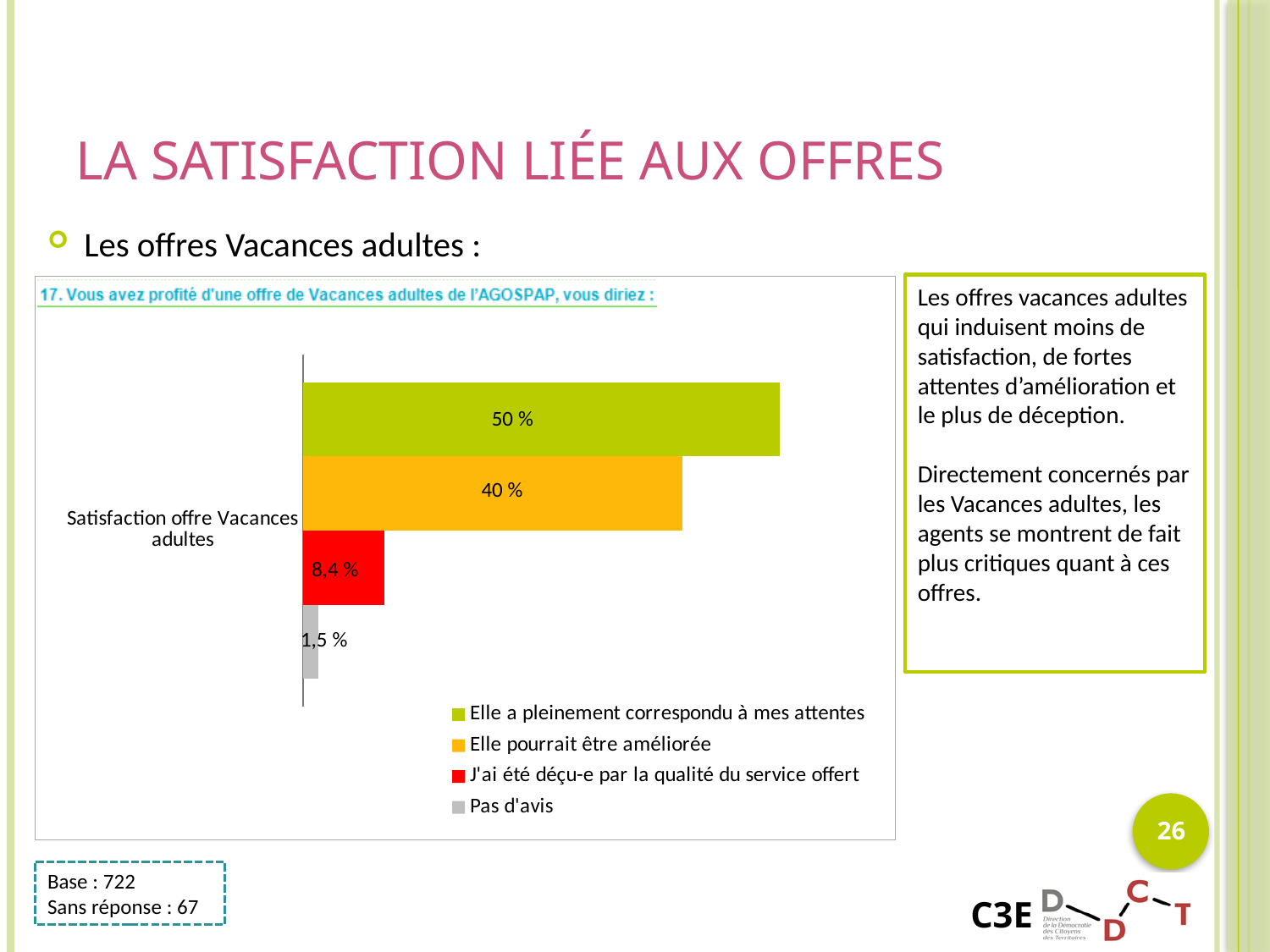
Which legend entry has the highest value? Elle a pleinement correspondu à mes attentes What value is shown for "Pas d'avis"? 1,5 % What is the difference between the values for "Elle a pleinement correspondu à mes attentes" and "Elle pourrait être améliorée"? 10 % How many series does the legend list? 4 Which is larger: the value for "J'ai été déçu-e par la qualité du service offert" or the value for "Pas d'avis"? J'ai été déçu-e par la qualité du service offert What kind of chart is shown on the slide? Bar chart What is the category label shown on the chart's axis? Satisfaction offre Vacances adultes What value is shown for "J'ai été déçu-e par la qualité du service offert"? 8,4 % Which legend entry has the lowest value? Pas d'avis What colour is the bar for "J'ai été déçu-e par la qualité du service offert"? Red What value is shown for "Elle pourrait être améliorée"? 40 % What value is shown for "Elle a pleinement correspondu à mes attentes"? 50 %